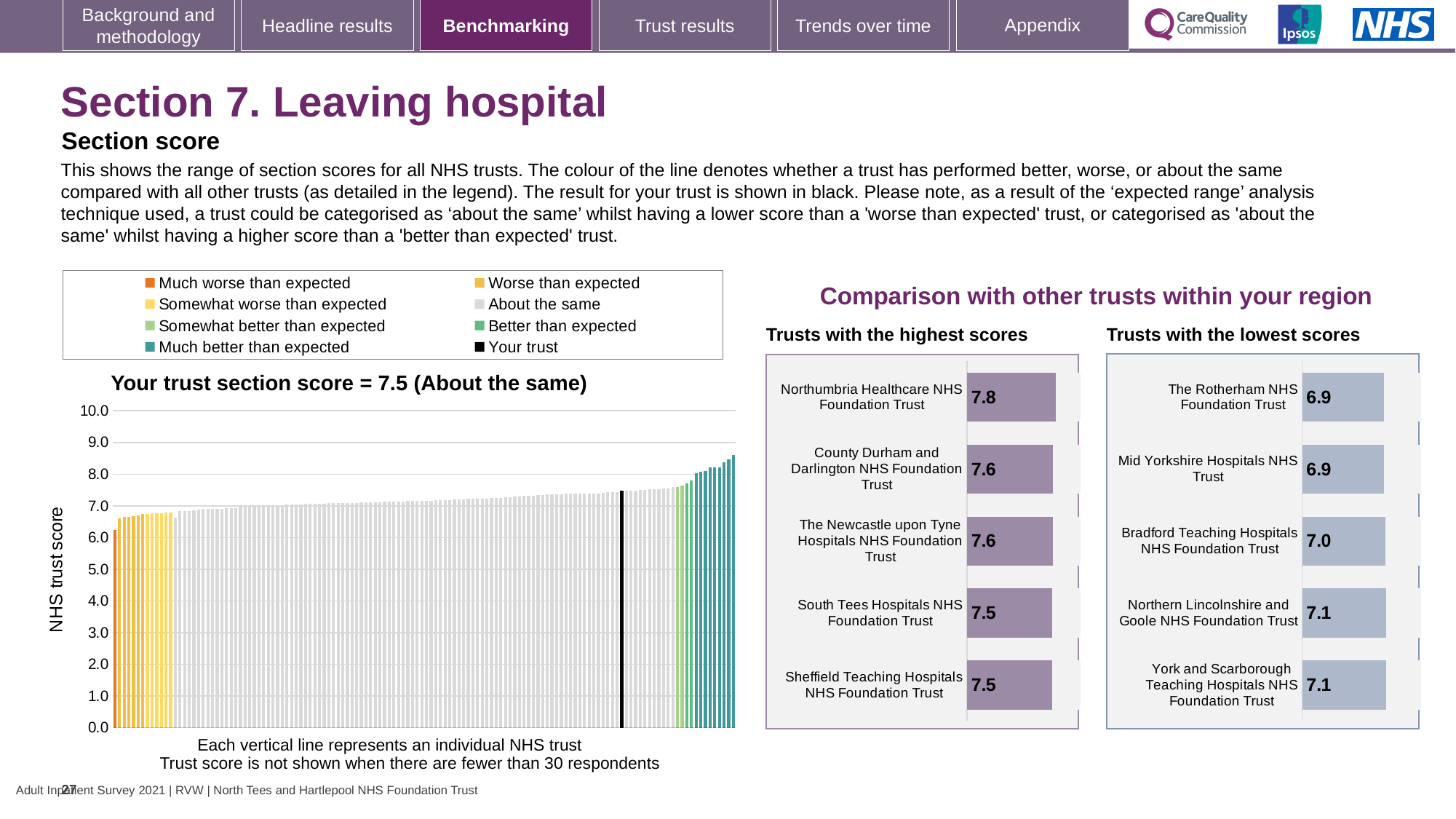
In the 'Trusts with the lowest scores' chart, what is the score for Bradford Teaching Hospitals NHS Foundation Trust? 7.0 In the 'Trusts with the highest scores' chart, what is the difference between the scores of Northumbria Healthcare NHS Foundation Trust and Sheffield Teaching Hospitals NHS Foundation Trust? 0.3 In the main chart, is the value of the rightmost (highest) bar greater or less than 8.0? greater In the main chart, how many entries does the legend list? 8 In the 'Trusts with the highest scores' chart, which trust has the highest score? Northumbria Healthcare NHS Foundation Trust In the 'Trusts with the highest scores' chart, what is the score for Northumbria Healthcare NHS Foundation Trust? 7.8 In the main chart, what is the section score for your trust? 7.5 In the 'Trusts with the highest scores' chart, how many trusts are shown? 5 In the main chart, what is the label on the vertical axis? NHS trust score In the main chart, do the trust scores rise or fall from left to right along the x axis? rise In the 'Trusts with the lowest scores' chart, which has the larger score: Bradford Teaching Hospitals NHS Foundation Trust or The Rotherham NHS Foundation Trust? Bradford Teaching Hospitals NHS Foundation Trust In the main chart 'Your trust section score', what kind of chart is it? bar chart